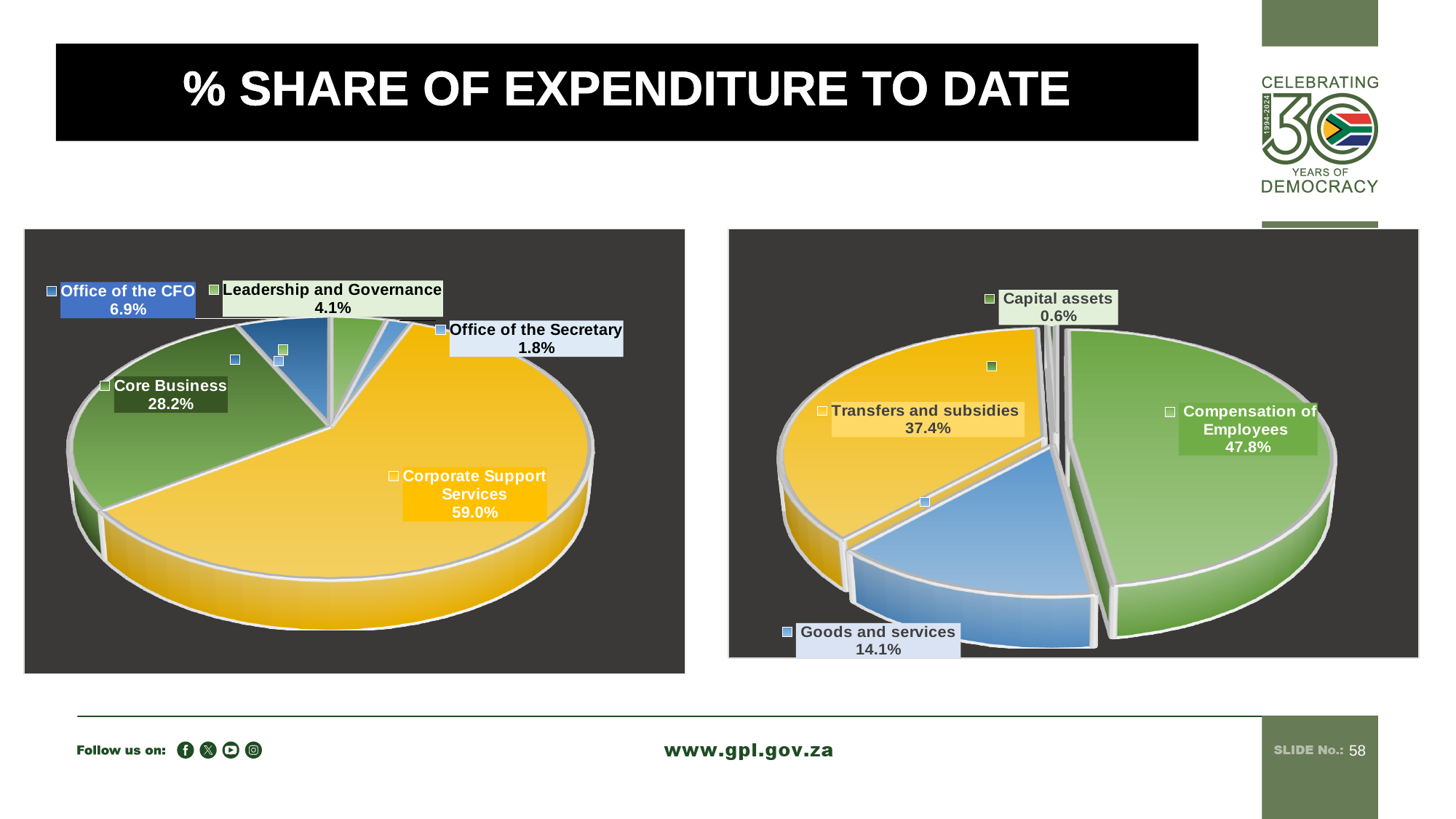
In the right pie chart, what share does Goods and services have? 14.1% In the left pie chart, what share does Corporate Support Services have? 59.0% In the left pie chart, what share does Core Business have? 28.2% What type of chart is used on the right side of the slide? Pie chart In the right pie chart, which category has the smallest share? Capital assets How many categories are shown in the left pie chart? 5 In the left pie chart, which category has the largest share? Corporate Support Services In the left pie chart, what is the difference between the shares of Office of the CFO and Leadership and Governance? 2.8% In the right pie chart, what share does Transfers and subsidies have? 37.4% In the left pie chart, which category has the smallest share? Office of the Secretary In the right pie chart, which category has the largest share? Compensation of Employees In the right pie chart, what is the difference between the shares of Compensation of Employees and Transfers and subsidies? 10.4%